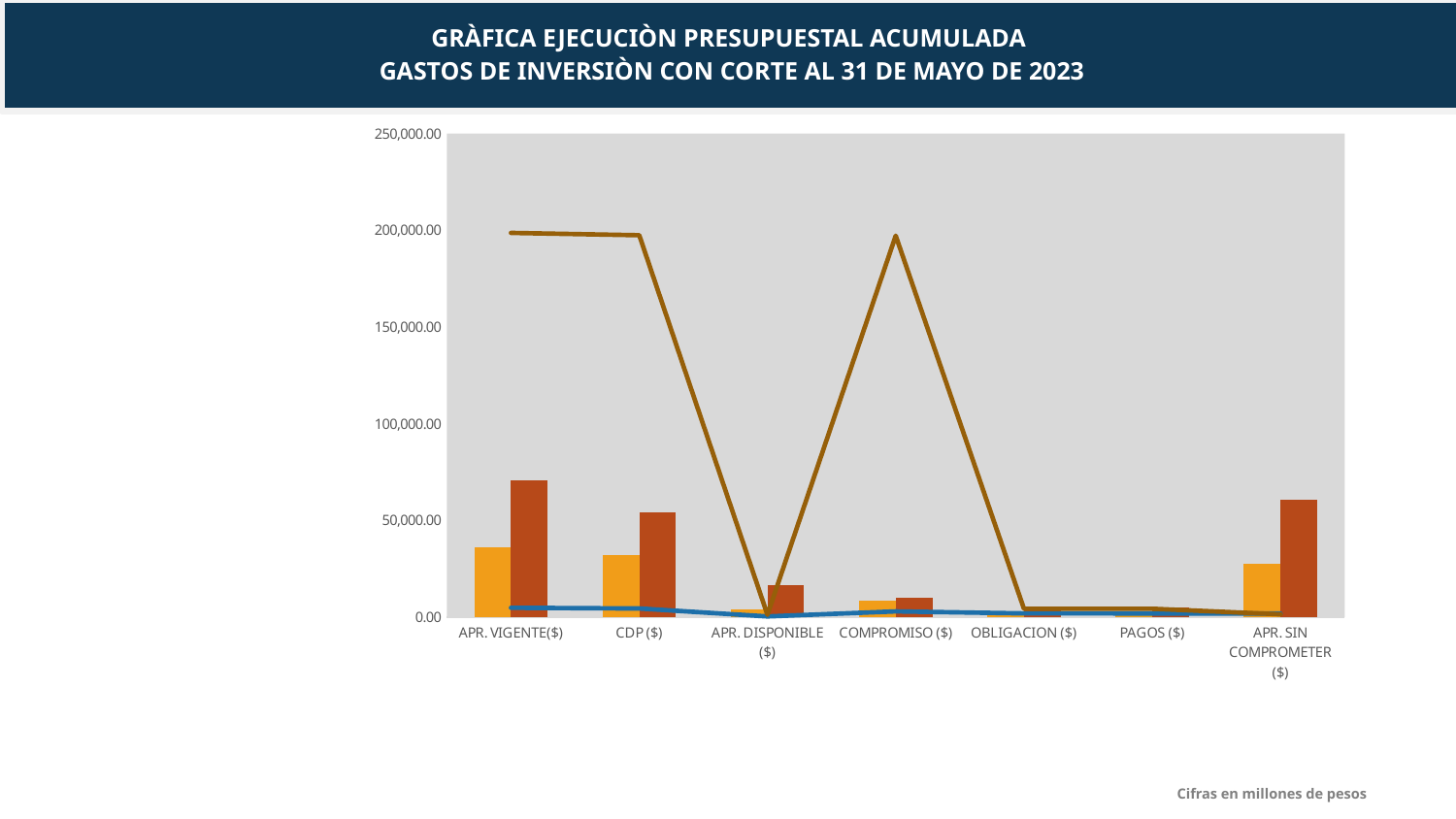
Which category has the tallest dark orange bar? APR. VIGENTE($) Is the value of the brown line for APR. VIGENTE($) greater or less than 150,000.00? greater How many categories are shown along the x axis of the chart? 7 Which is larger, the dark orange bar for APR. VIGENTE($) or the dark orange bar for APR. DISPONIBLE ($)? APR. VIGENTE($) What kind of chart is shown on the slide? A combination bar and line chart Does the brown line rise or fall between CDP ($) and APR. DISPONIBLE ($)? It falls Is the dark orange bar for CDP ($) greater or less than 100,000.00? less Is the dark orange bar for APR. VIGENTE($) greater or less than 50,000.00? greater What is the highest value shown on the y axis of the chart? 250,000.00